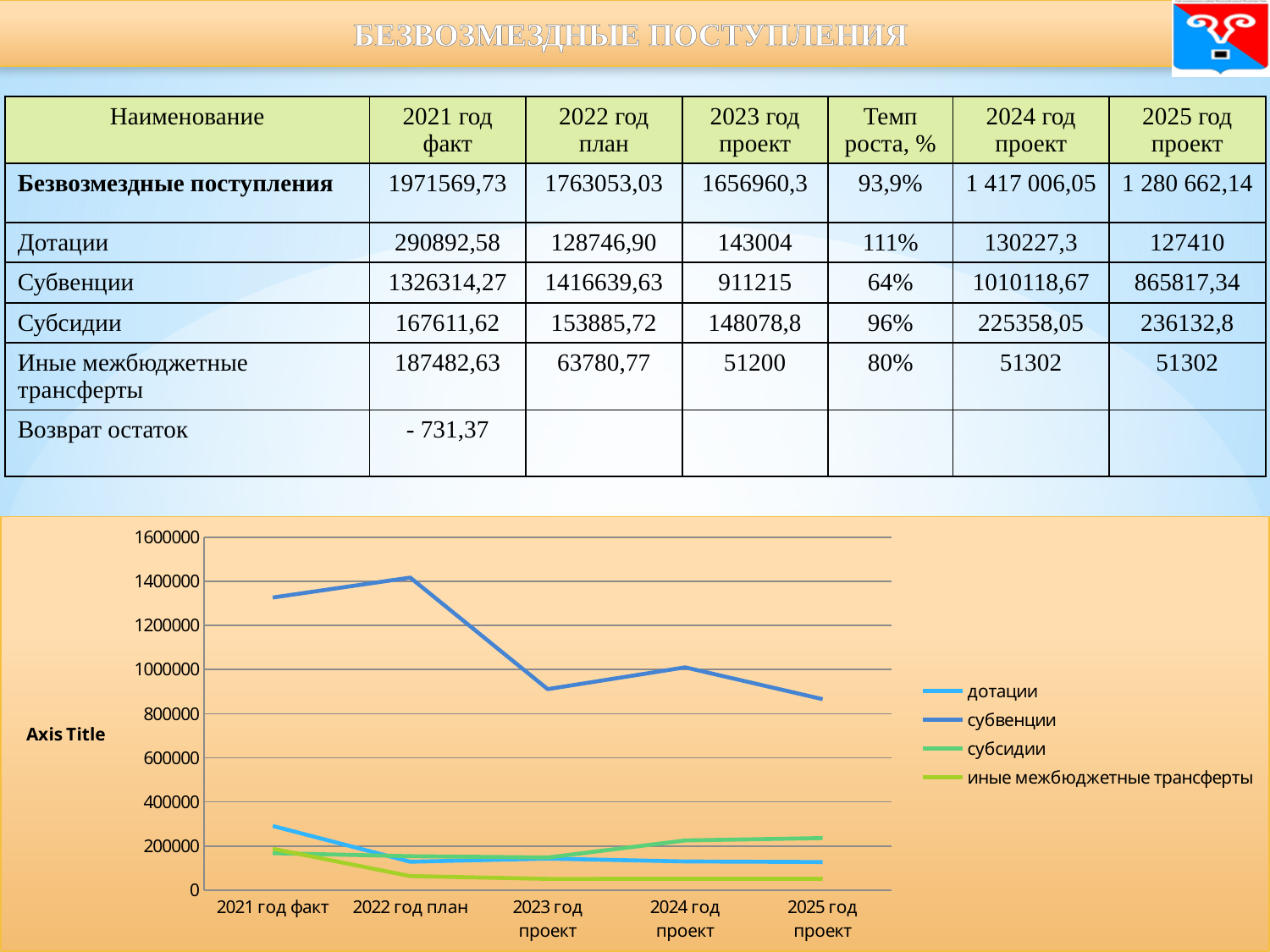
In the chart, is the value of субвенции for 2023 год проект greater or less than 1000000? less What text is shown as the vertical axis title of the chart? Axis Title How many series does the chart legend list? 4 In the chart, is the value of дотации for 2021 год факт greater or less than 200000? greater How many categories are shown along the x axis of the chart? 5 What kind of chart is shown at the bottom of the slide? line chart In the chart, is the value of субвенции for 2022 год план greater or less than 1200000? greater Which series has the lowest value at 2025 год проект in the chart? иные межбюджетные трансферты In the chart, does the субвенции line rise or fall from 2022 год план to 2023 год проект? fall In the chart, which is larger for субвенции: the value for 2021 год факт or for 2022 год план? 2022 год план Which series has the highest value at 2022 год план in the chart? субвенции